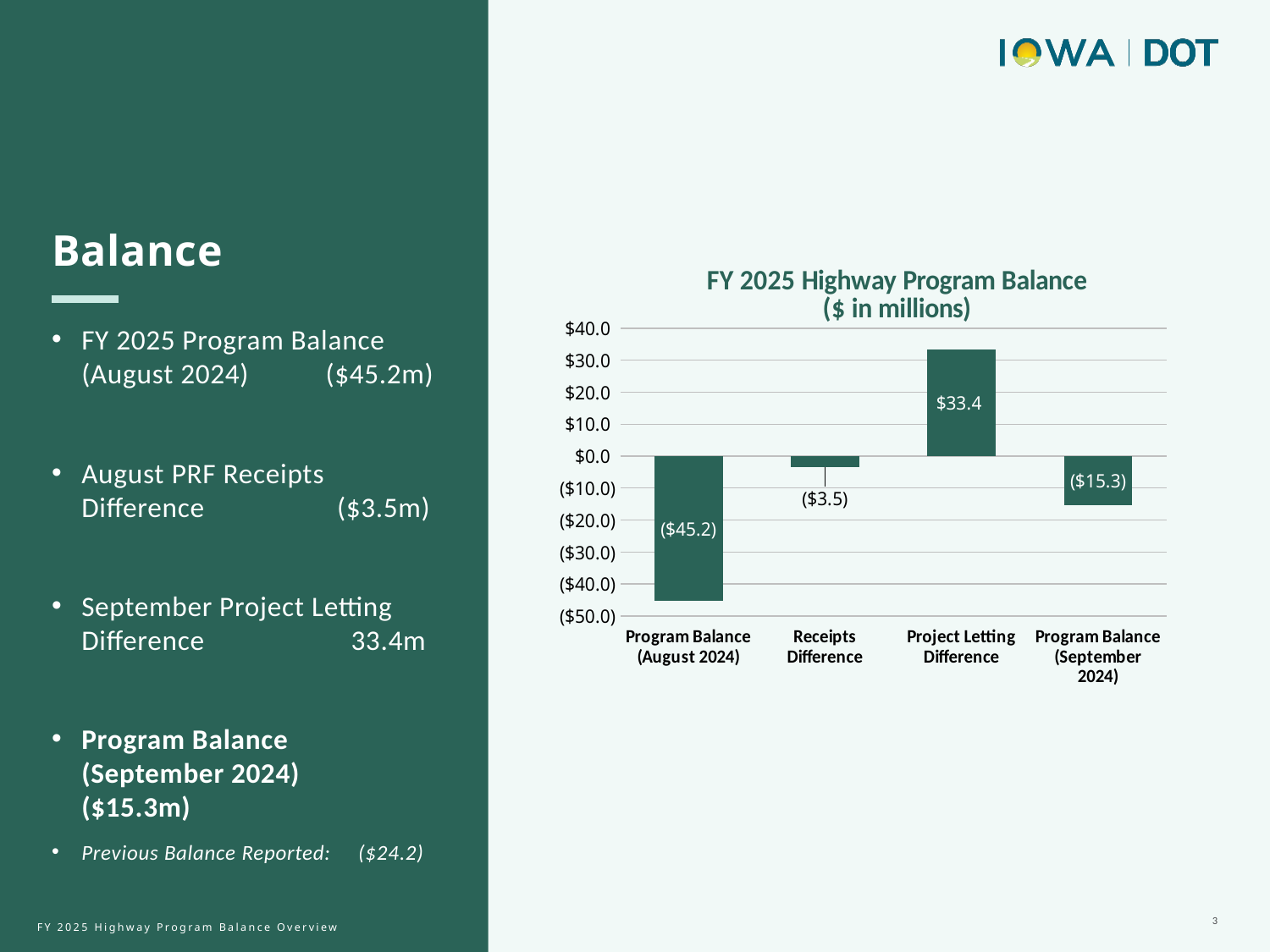
What type of chart is shown on the slide? bar chart What is the value for Program Balance (September 2024)? ($15.3) Is the value for Program Balance (August 2024) greater or less than ($40.0)? less What is the value for Program Balance (August 2024)? ($45.2) How many categories are shown on the x axis? 4 Which category has the highest value? Project Letting Difference What is the value for Project Letting Difference? $33.4 What is the title of the chart? FY 2025 Highway Program Balance ($ in millions) Which is larger, the value for Receipts Difference or the value for Program Balance (September 2024)? Receipts Difference Is the value for Project Letting Difference greater or less than $30.0? greater Which category has the lowest value? Program Balance (August 2024) What is the value for Receipts Difference? ($3.5)